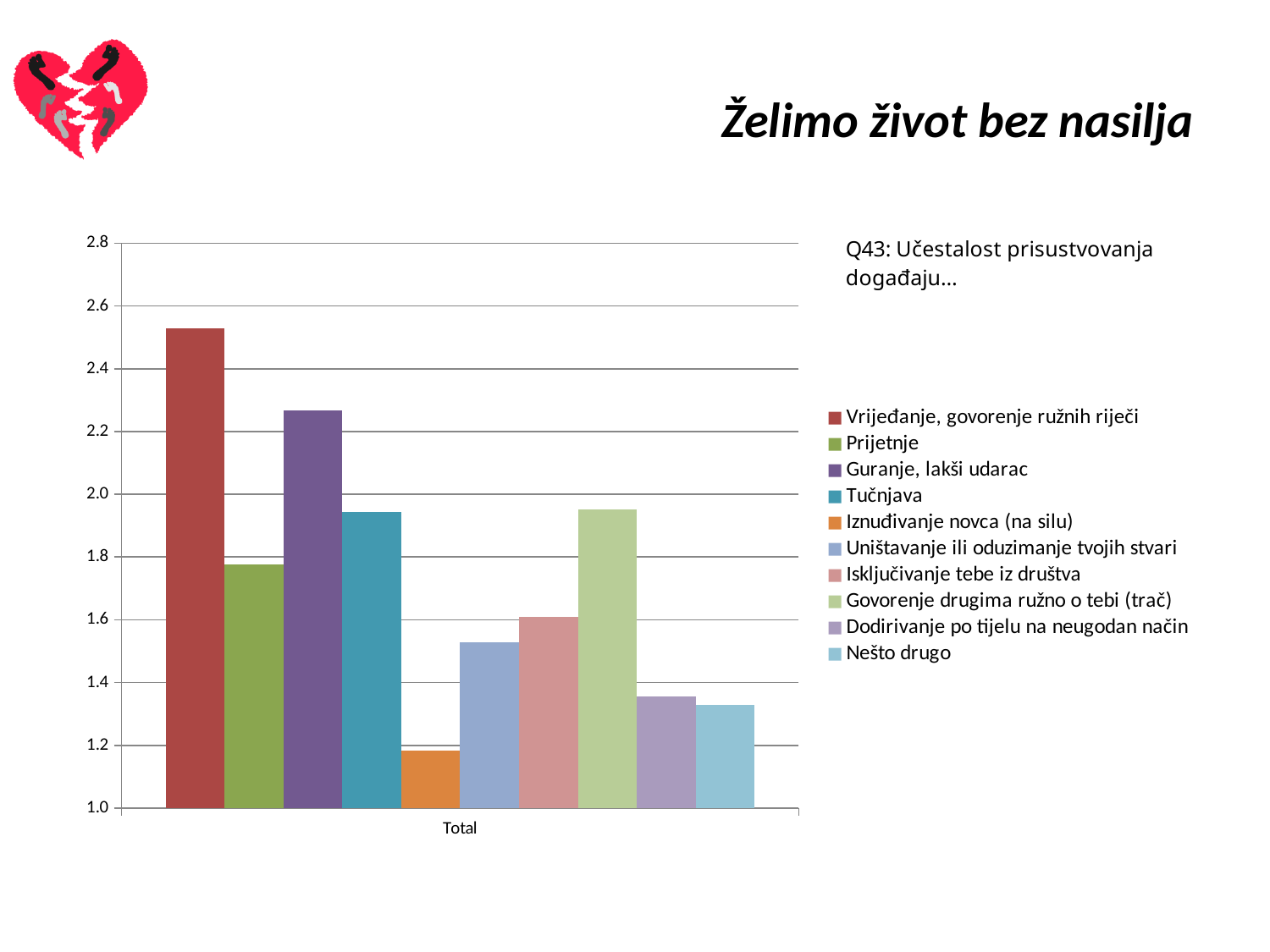
Which is larger, the value for Prijetnje or the value for Isključivanje tebe iz društva? Prijetnje What kind of chart is shown on the slide? bar chart What is the label of the single category on the x axis? Total Which is larger, the value for Guranje, lakši udarac or the value for Tučnjava? Guranje, lakši udarac Is the value for Tučnjava greater or less than 2.0? less Is the value for Vrijeđanje, govorenje ružnih riječi greater or less than 2.4? greater How many series does the legend list? 10 Which series has the highest bar? Vrijeđanje, govorenje ružnih riječi Is the value for Guranje, lakši udarac greater or less than 2.2? greater Which series has the lowest bar? Iznuđivanje novca (na silu)